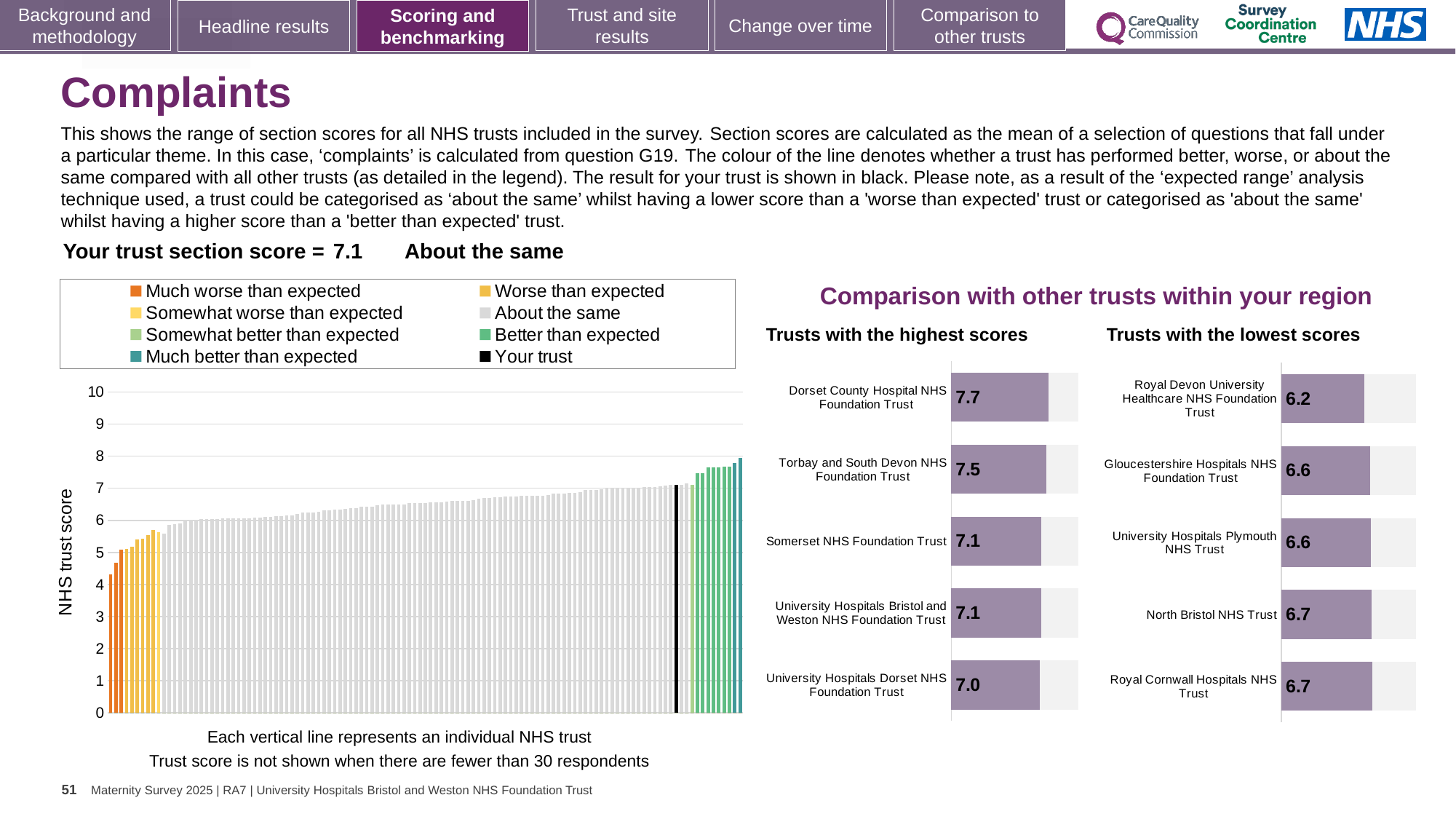
In the 'Trusts with the lowest scores' chart, what is the score for North Bristol NHS Trust? 6.7 In the 'Trusts with the highest scores' chart, which trust has the highest score? Dorset County Hospital NHS Foundation Trust In the 'Trusts with the lowest scores' chart, what is the difference between the scores of Royal Cornwall Hospitals NHS Trust and Royal Devon University Healthcare NHS Foundation Trust? 0.5 What kind of chart is the large chart on the left showing all NHS trusts? Bar chart In the 'Trusts with the lowest scores' chart, which has the larger score: Gloucestershire Hospitals NHS Foundation Trust or North Bristol NHS Trust? North Bristol NHS Trust In the 'Trusts with the lowest scores' chart, which trust has the lowest score? Royal Devon University Healthcare NHS Foundation Trust In the 'Trusts with the highest scores' chart, what is the score for Dorset County Hospital NHS Foundation Trust? 7.7 In the 'Trusts with the lowest scores' chart, what is the score for Royal Devon University Healthcare NHS Foundation Trust? 6.2 In the 'Trusts with the highest scores' chart, what is the difference between the scores of Dorset County Hospital NHS Foundation Trust and University Hospitals Dorset NHS Foundation Trust? 0.7 How many trusts are shown in the 'Trusts with the highest scores' chart? 5 In the large chart on the left showing all NHS trusts, is the value of the lowest bar greater or less than 5? less In the 'Trusts with the highest scores' chart, what is the score for Torbay and South Devon NHS Foundation Trust? 7.5